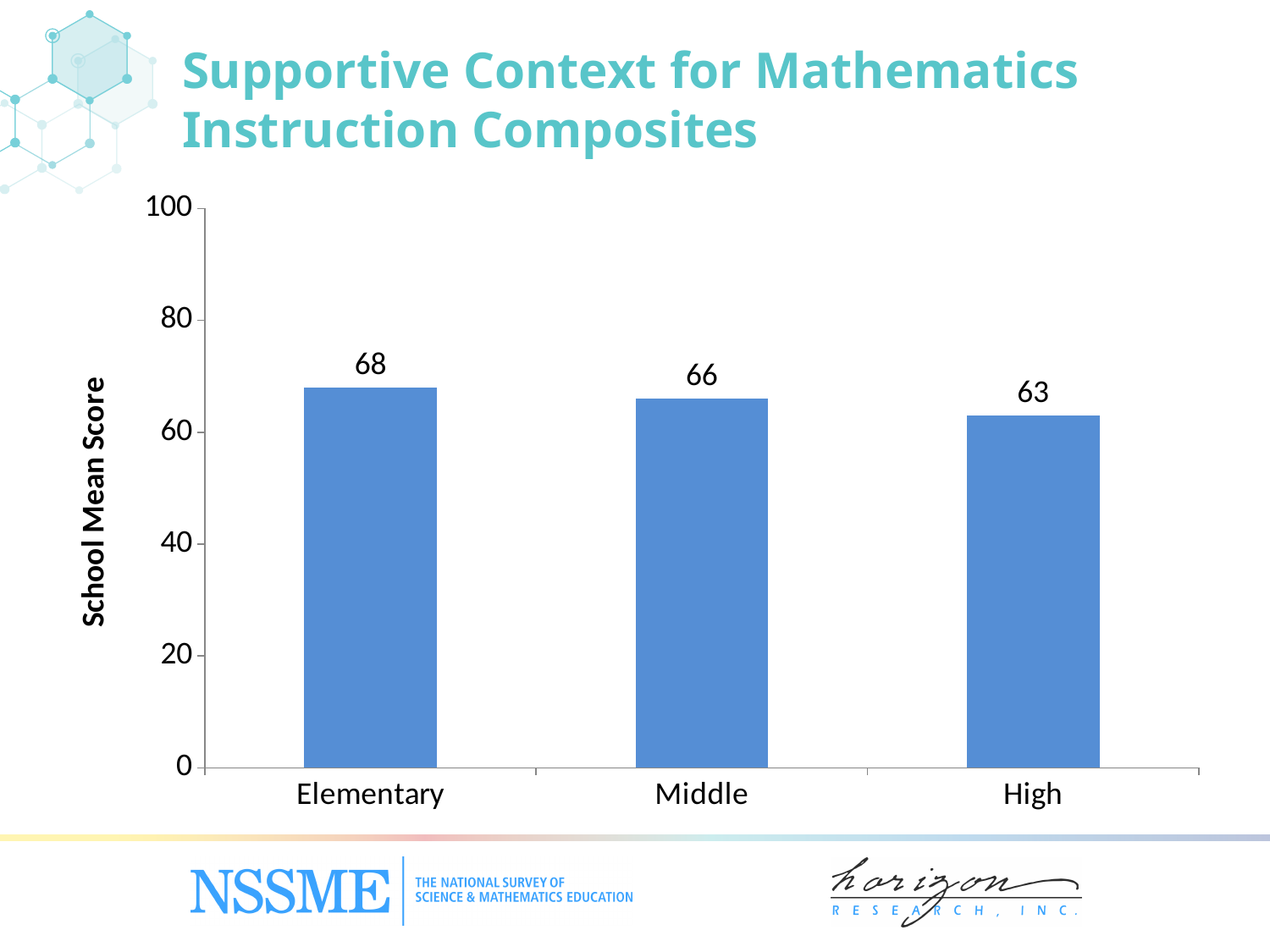
What is the difference between the Middle and High school mean scores? 3 What is the school mean score for High? 63 Which school level has the lowest school mean score? High What kind of chart is shown on the slide? Bar chart What is the label on the vertical axis of the chart? School Mean Score What is the school mean score for Middle? 66 Which has a higher school mean score, Middle or High? Middle How many school levels are shown on the chart? 3 Which school level has the highest school mean score? Elementary Is the value for High greater or less than 80? less What is the school mean score for Elementary? 68 What is the difference between the Elementary and High school mean scores? 5